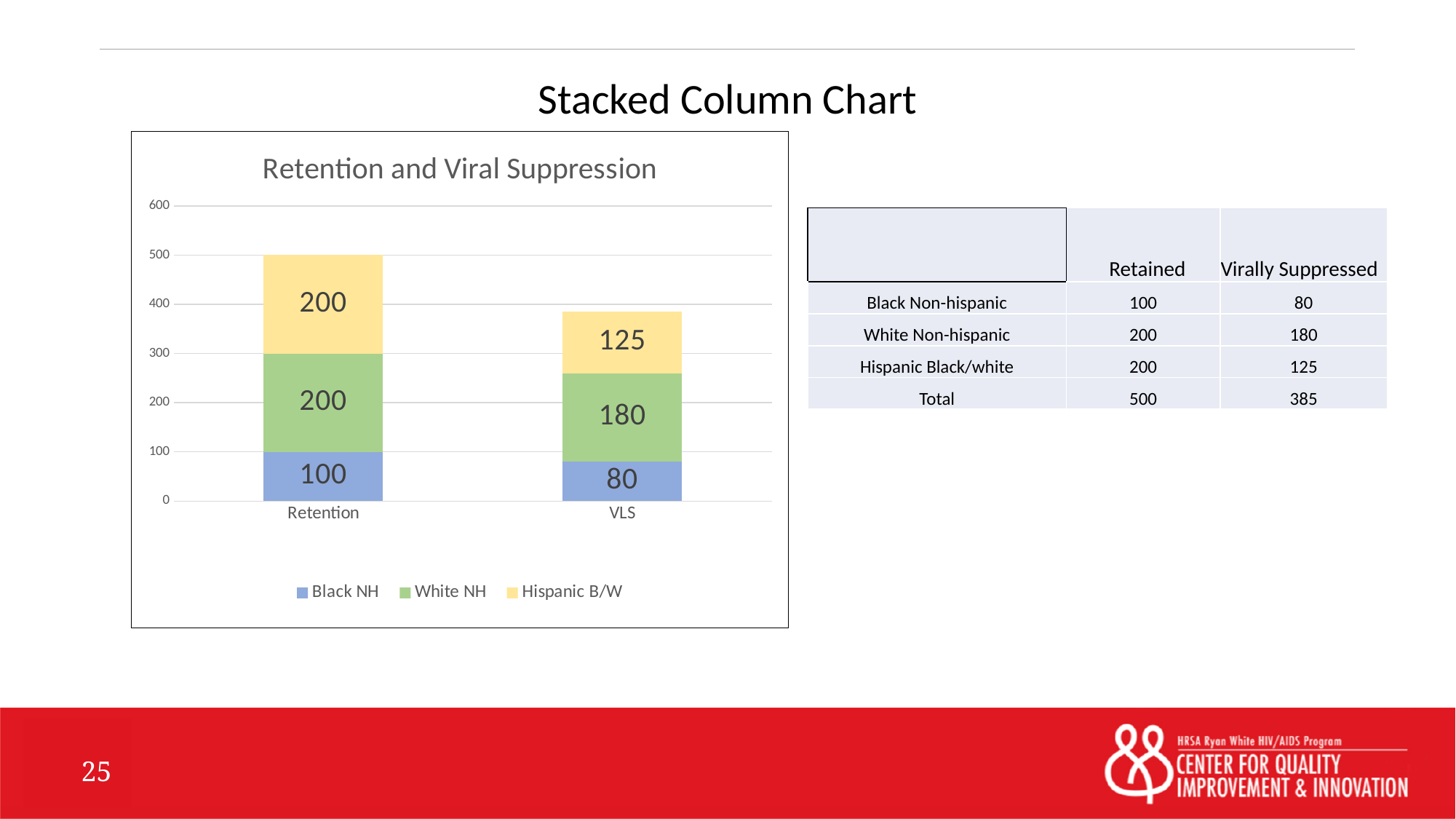
What is the title of the chart? Retention and Viral Suppression What is the difference between the Black NH values for Retention and VLS? 20 How many series does the legend list? 3 Which category has the taller stacked bar, Retention or VLS? Retention What is the value for Hispanic B/W in the VLS bar? 125 What is the value for Hispanic B/W in the Retention bar? 200 What is the total of the VLS stacked bar? 385 What is the total of the Retention stacked bar? 500 What is the difference between the Hispanic B/W values for Retention and VLS? 75 How many categories are shown on the x axis? 2 What is the value for White NH in the VLS bar? 180 What is the value for Black NH in the Retention bar? 100